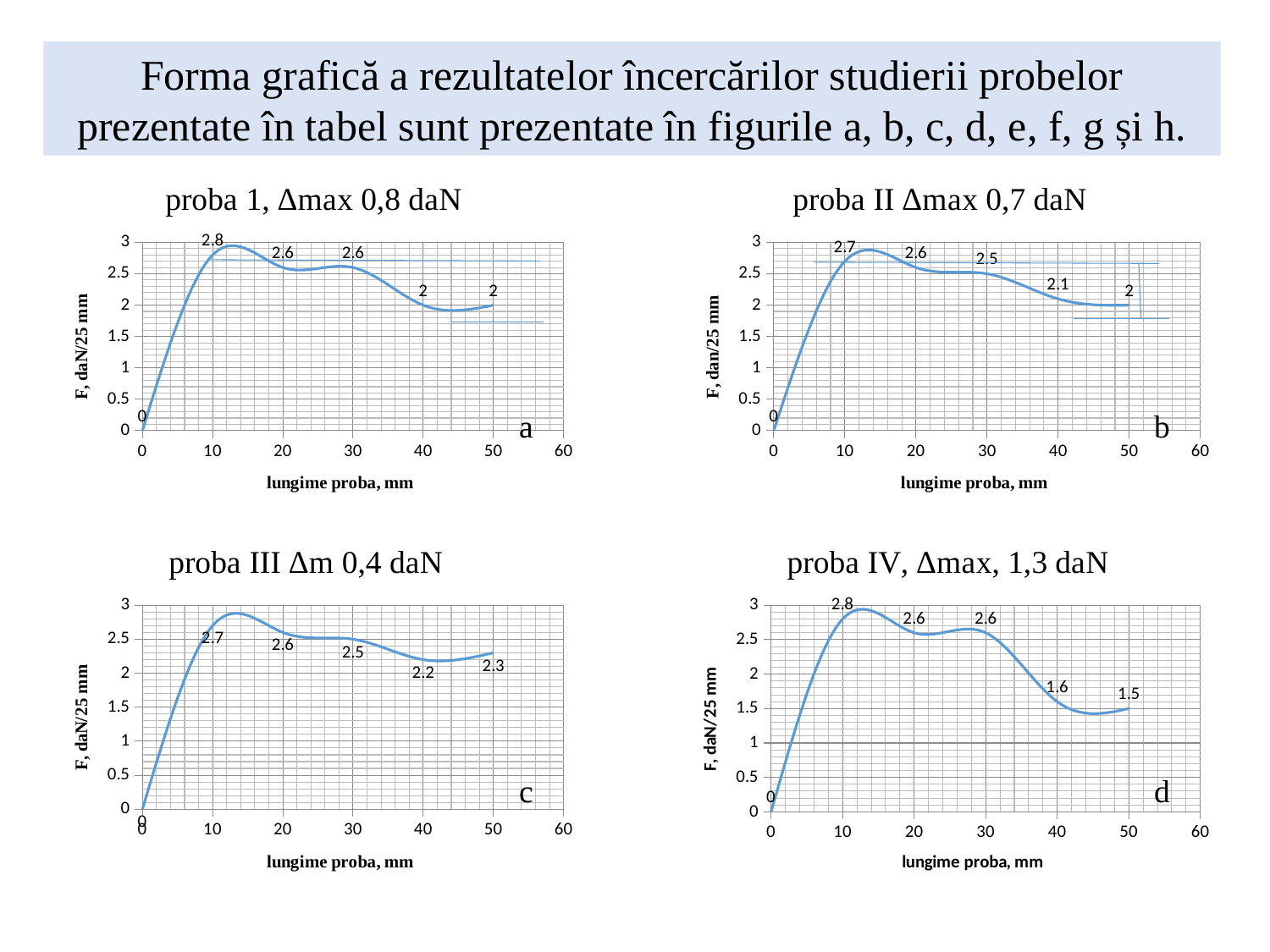
In chart c (proba III), which is larger: the value at 40 mm or the value at 50 mm? 50 mm In chart d (proba IV), what is the difference between the value at 10 mm and the value at 50 mm? 1.3 In chart d (proba IV), what is the value of F at lungime proba 40 mm? 1.6 What type of chart is chart a (proba 1)? line chart In chart b (proba II), what is the value of F at lungime proba 40 mm? 2.1 In chart b (proba II), at which lungime proba is the labelled value of F highest? 10 In chart c (proba III), what is the value of F at lungime proba 50 mm? 2.3 In chart b (proba II), how many labelled data points are there? 6 In chart a (proba 1), what is the value of F at lungime proba 10 mm? 2.8 In chart a (proba 1), what is the difference between the value at 10 mm and the value at 50 mm? 0.8 In chart d (proba IV), what is the lowest labelled non-zero value of F? 1.5 What is the y-axis label of chart c (proba III)? F, daN/25 mm